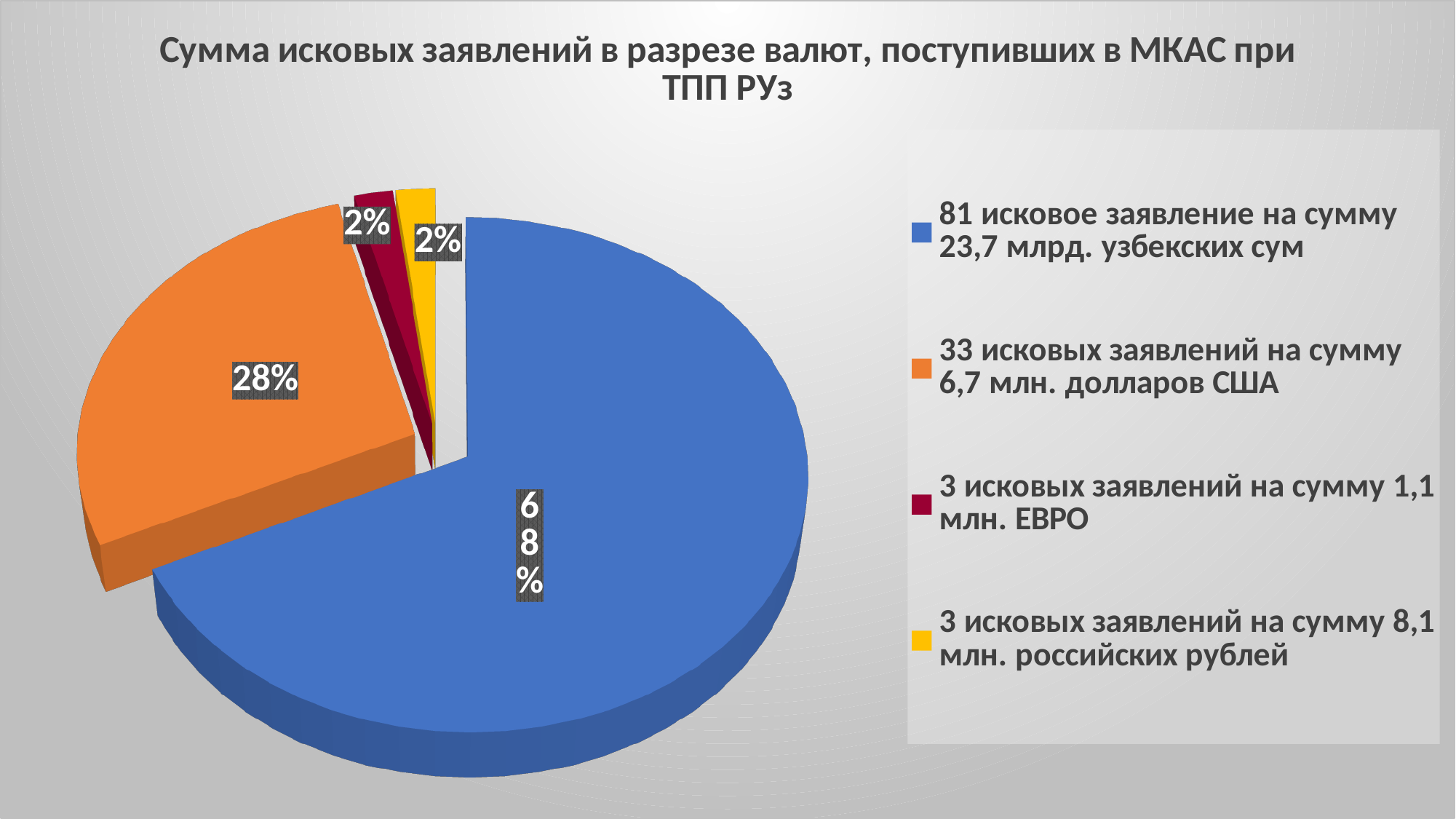
How many entries does the legend list? 4 What colour is the slice representing the claims in Russian roubles? yellow What is the title of the chart? Сумма исковых заявлений в разрезе валют, поступивших в МКАС при ТПП РУз Which legend entry corresponds to the largest slice of the pie? 81 исковое заявление на сумму 23,7 млрд. узбекских сум What kind of chart is shown on the slide? pie chart How many slices does the pie chart have? 4 What share of the pie is the slice for the 33 claims totalling 6,7 million US dollars? 28% What share of the pie is the slice for the 3 claims totalling 1,1 million euro? 2% What is the difference in percentage points between the Uzbek sum slice and the US dollar slice? 40% What share of the pie is the slice for the 81 claims totalling 23,7 billion Uzbek sum? 68% Which is larger: the share for the US dollar claims or the share for the euro claims? US dollar claims